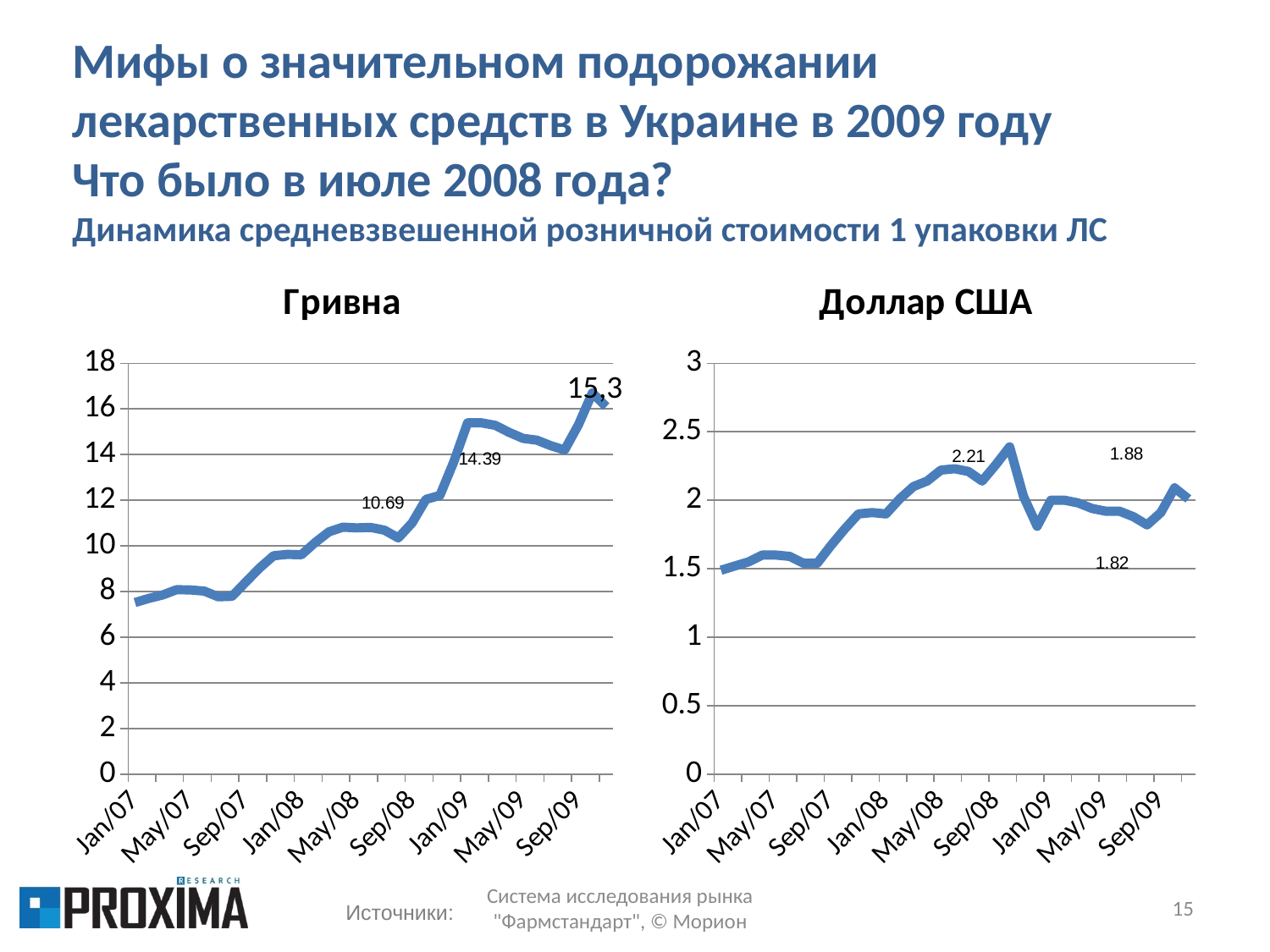
In the "Доллар США" chart, what is the lowest value printed as a data label? 1.82 In the "Доллар США" chart, what is the highest value printed as a data label? 2.21 In the "Доллар США" chart, is the value for Jan/09 greater or less than 2.5? less What kind of chart is the "Гривна" chart? line chart In the "Гривна" chart, is the value for Jan/07 greater or less than 8? less What is the title of the right-hand chart? Доллар США In the "Доллар США" chart, what is the difference between the labelled values 2.21 and 1.82? 0.39 In the "Доллар США" chart, is the value for Jan/07 greater or less than 2? less How many charts are shown on the slide? 2 In the "Гривна" chart, what is the highest value printed as a data label? 15,3 In the "Гривна" chart, does the value overall rise or fall from Jan/07 to Sep/09? rise